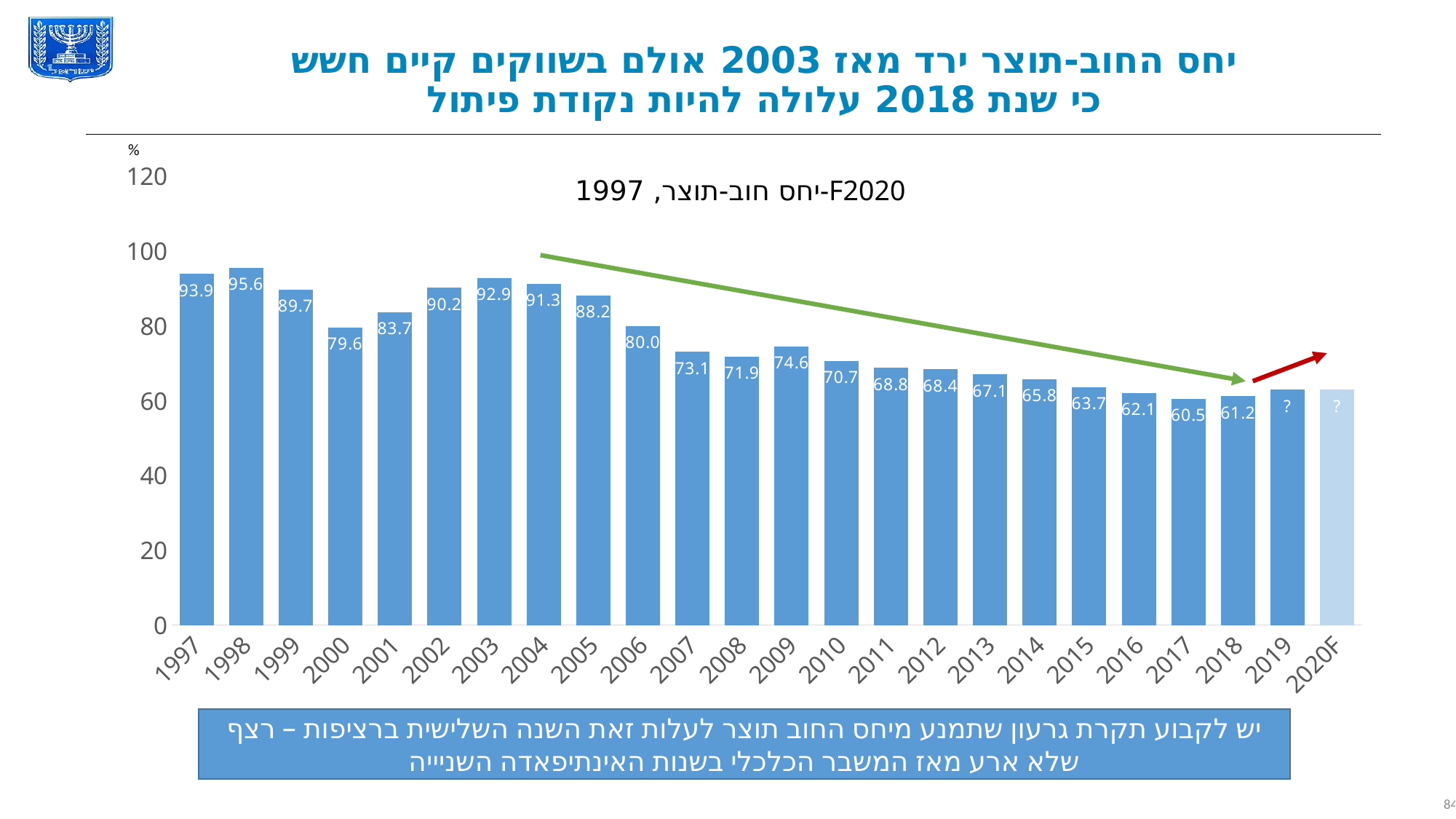
What is the debt-to-GDP ratio value shown for 2003? 92.9 Do the values generally rise or fall from 2003 to 2017? fall Which is larger, the value for 2001 or the value for 2000? 2001 What is the difference between the values for 2003 and 2018? 31.7 What is the difference between the values for 1998 and 2017? 35.1 Which year has the highest value in the chart? 1998 What is the value shown for 2000? 79.6 Is the value for 2019 greater or less than 60? greater What type of chart is shown on the slide? bar chart Which bar is shown in a lighter shade of blue than the others? 2020F What is the value shown for 2018? 61.2 How many years (bars) are shown on the x axis? 24